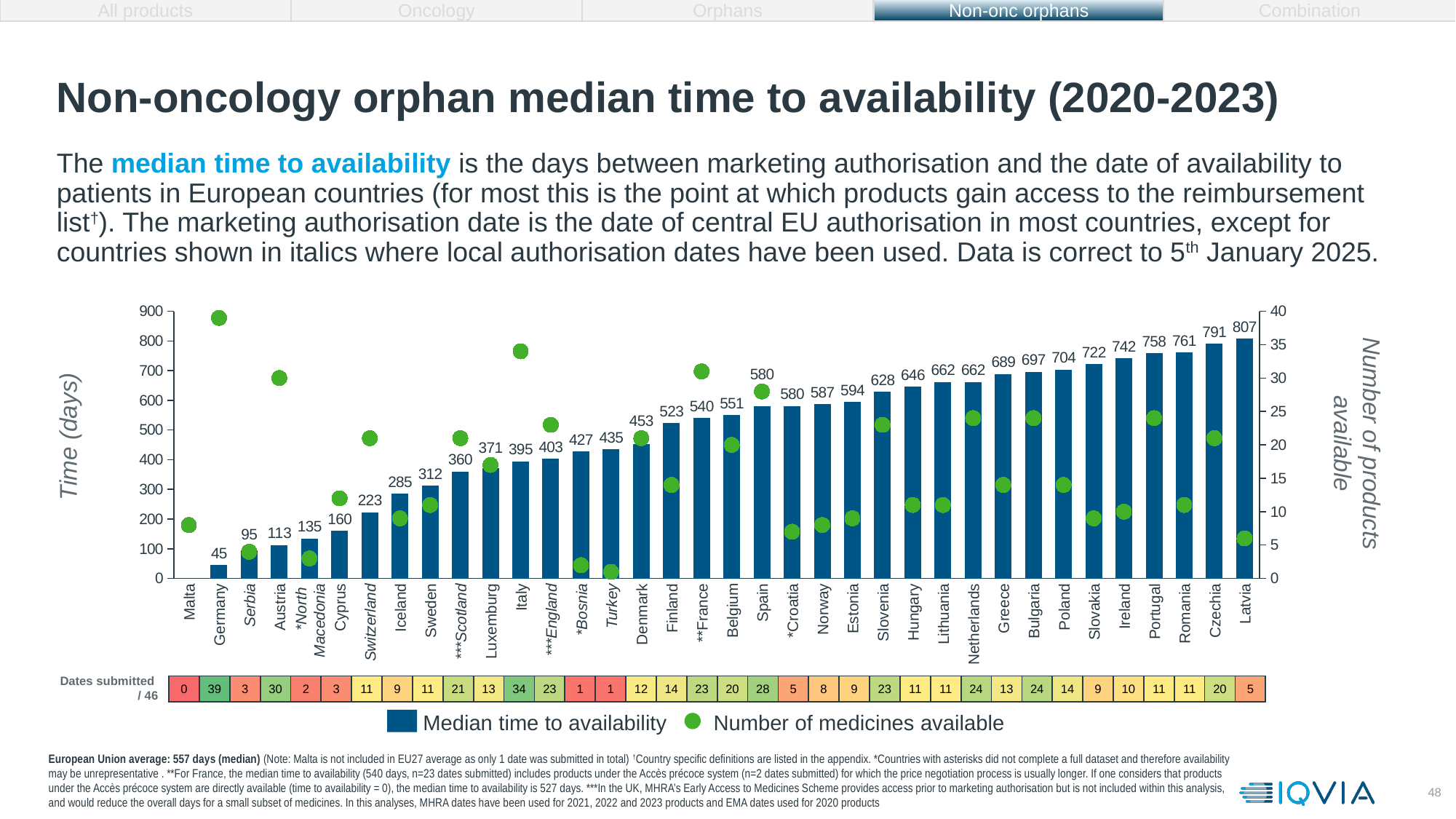
How many series does the legend list? 2 What kind of chart is used to show the median time to availability? bar chart Do the median time to availability bars rise or fall from left to right? rise Is the number of medicines available for Germany greater or less than 35? greater What is the median time to availability for France? 540 How many countries are shown on the x axis of the chart? 36 Which has a longer median time to availability, France or Belgium? Belgium What is the median time to availability for Latvia? 807 Which country has the highest median time to availability? Latvia What is the difference in median time to availability between Latvia and Germany? 762 What is the median time to availability for Germany? 45 Which country has the shortest bar for median time to availability? Germany